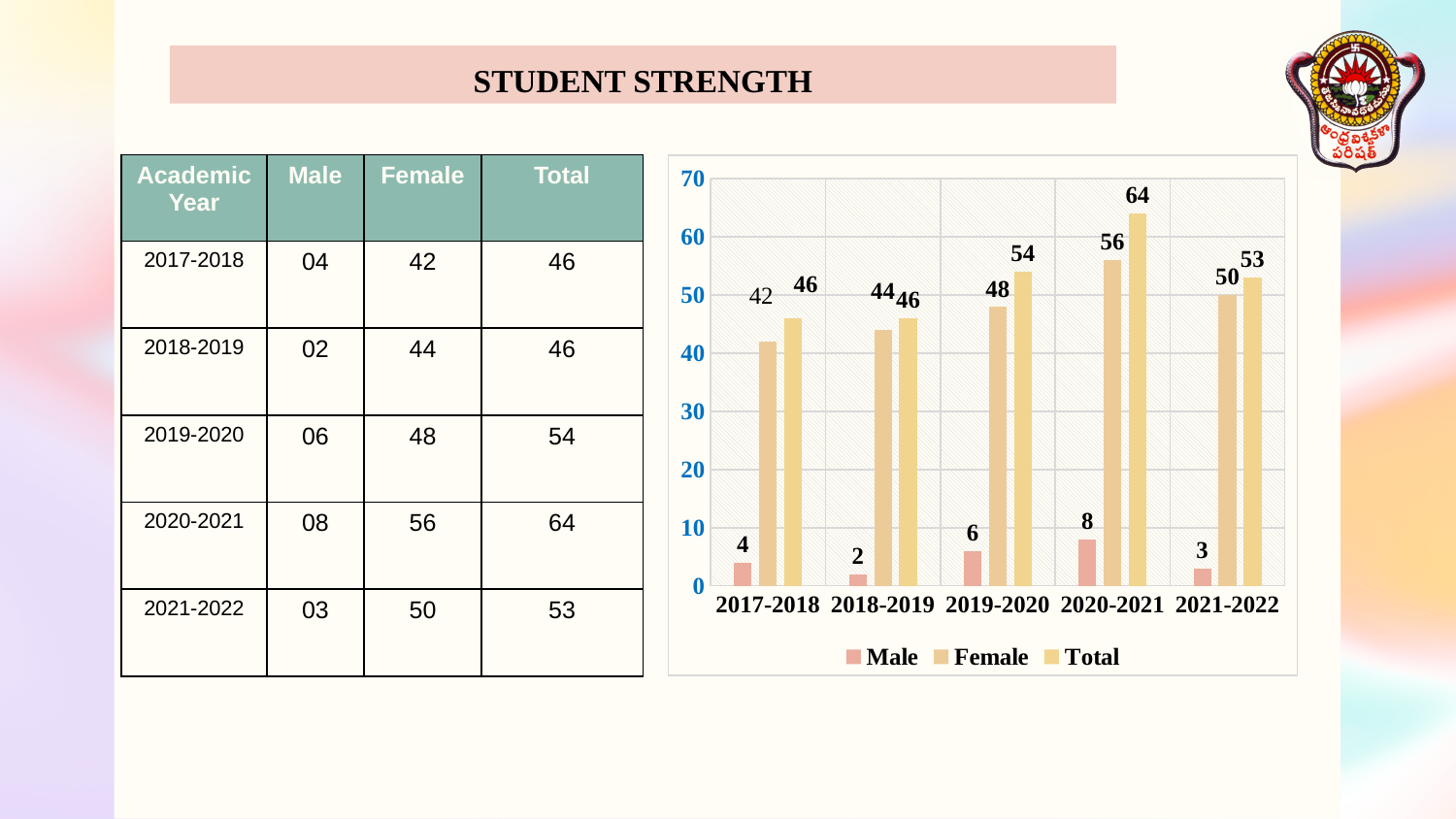
What is the difference between the Total values for 2020-2021 and 2021-2022? 11 Is the Total value for 2019-2020 greater or less than 50? greater What is the Total value for 2020-2021 in the chart? 64 What is the Male value for 2018-2019 in the chart? 2 How many series does the chart legend list? 3 How many academic years are shown on the x axis of the chart? 5 Which academic year has the lowest Male value? 2018-2019 Which is larger, the Female value for 2017-2018 or the Female value for 2021-2022? 2021-2022 Which academic year has the highest Total value? 2020-2021 What kind of chart is shown on the slide? bar chart Does the Female value rise or fall from 2017-2018 to 2020-2021? rise What is the Female value for 2019-2020 in the chart? 48